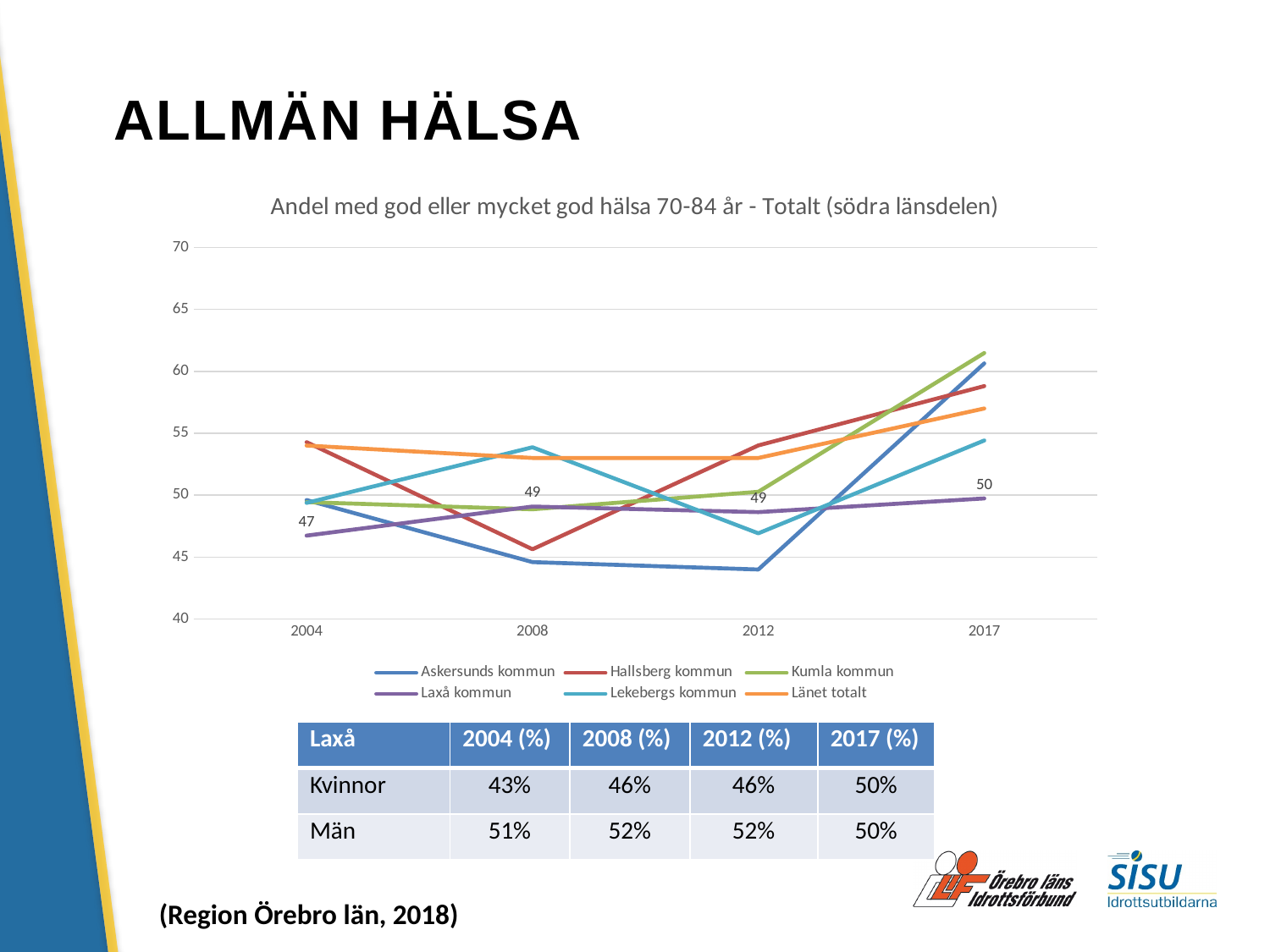
How many series does the chart's legend list? 6 What kind of chart is shown on the slide? line chart Is the value for Askersunds kommun in 2012 greater or less than 45? less How many years are plotted along the x axis of the chart? 4 Which series has the highest value in 2008? Lekebergs kommun Which series has the lowest value in 2012? Askersunds kommun By how much did the value for Laxå kommun change from 2004 to 2017? 3 What is the value for Laxå kommun in 2004? 47 What is the value for Laxå kommun in 2017? 50 Which is larger in 2017, Hallsberg kommun or Laxå kommun? Hallsberg kommun Does the value for Laxå kommun rise or fall from 2004 to 2017? rise What is the value for Laxå kommun in 2008? 49